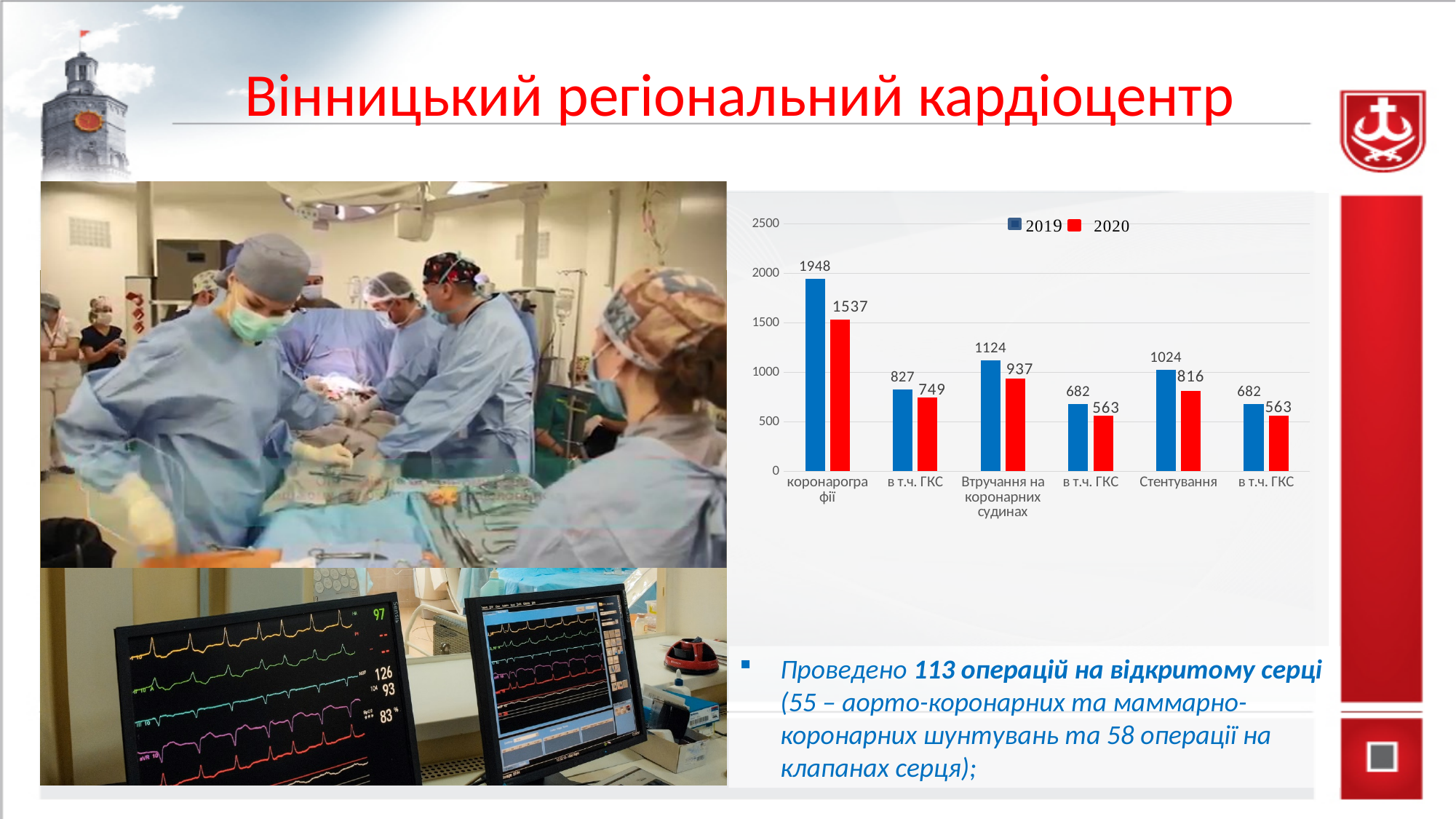
What is the difference between the 2019 and 2020 values for Стентування? 208 What is the 2020 value for Стентування? 816 Which is larger: the 2019 value for Стентування or the 2019 value for Втручання на коронарних судинах? Втручання на коронарних судинах What is the 2020 value for коронарографії? 1537 How many categories are shown on the x axis of the chart? 6 What kind of chart is shown on the slide? Bar chart Which category has the lowest 2020 value? в т.ч. ГКС (563) Which category has the highest 2019 value? коронарографії How many series does the chart legend list? 2 What is the difference between the 2019 and 2020 values for коронарографії? 411 What is the 2019 value for коронарографії? 1948 What is the 2019 value for Втручання на коронарних судинах? 1124